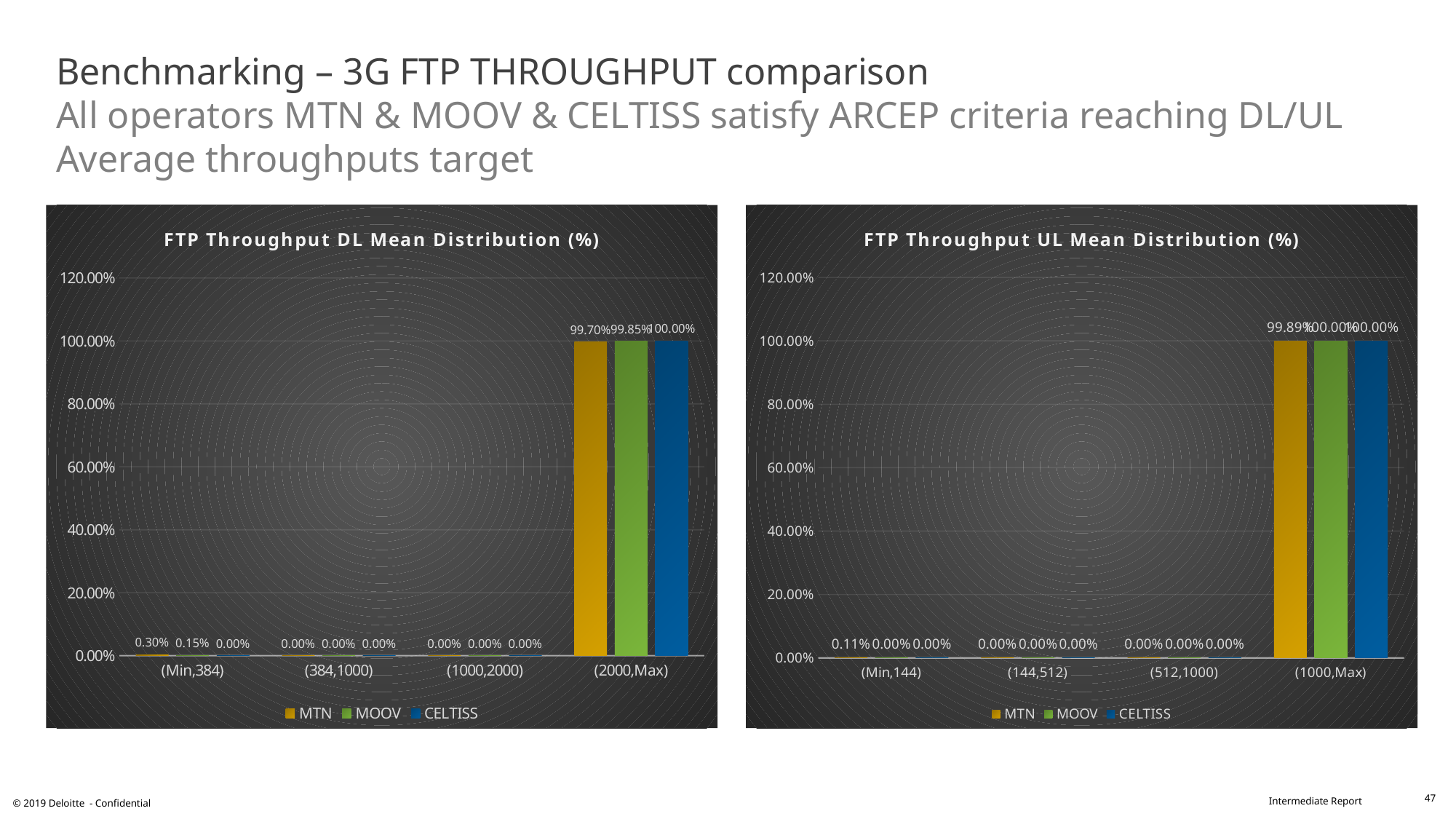
In the FTP Throughput UL Mean Distribution chart, what is the difference between the MOOV and MTN values in the (1000,Max) category? 0.11% In the FTP Throughput UL Mean Distribution chart, what is the value for MTN in the (Min,144) category? 0.11% In the FTP Throughput DL Mean Distribution chart, what is the difference between the CELTISS and MTN values in the (2000,Max) category? 0.30% In the FTP Throughput DL Mean Distribution chart, which colour represents CELTISS? Blue In the FTP Throughput DL Mean Distribution chart, what is the value for MOOV in the (2000,Max) category? 99.85% How many series does the legend of the FTP Throughput DL Mean Distribution chart list? 3 In the FTP Throughput DL Mean Distribution chart, which operator has the highest value in the (2000,Max) category? CELTISS What kind of chart is the FTP Throughput UL Mean Distribution chart? Bar chart In the FTP Throughput DL Mean Distribution chart, what is the value for MTN in the (2000,Max) category? 99.70% In the FTP Throughput DL Mean Distribution chart, what is the value for MTN in the (Min,384) category? 0.30% In the FTP Throughput UL Mean Distribution chart, what is the value for MTN in the (1000,Max) category? 99.89% How many categories are shown on the x axis of the FTP Throughput UL Mean Distribution chart? 4